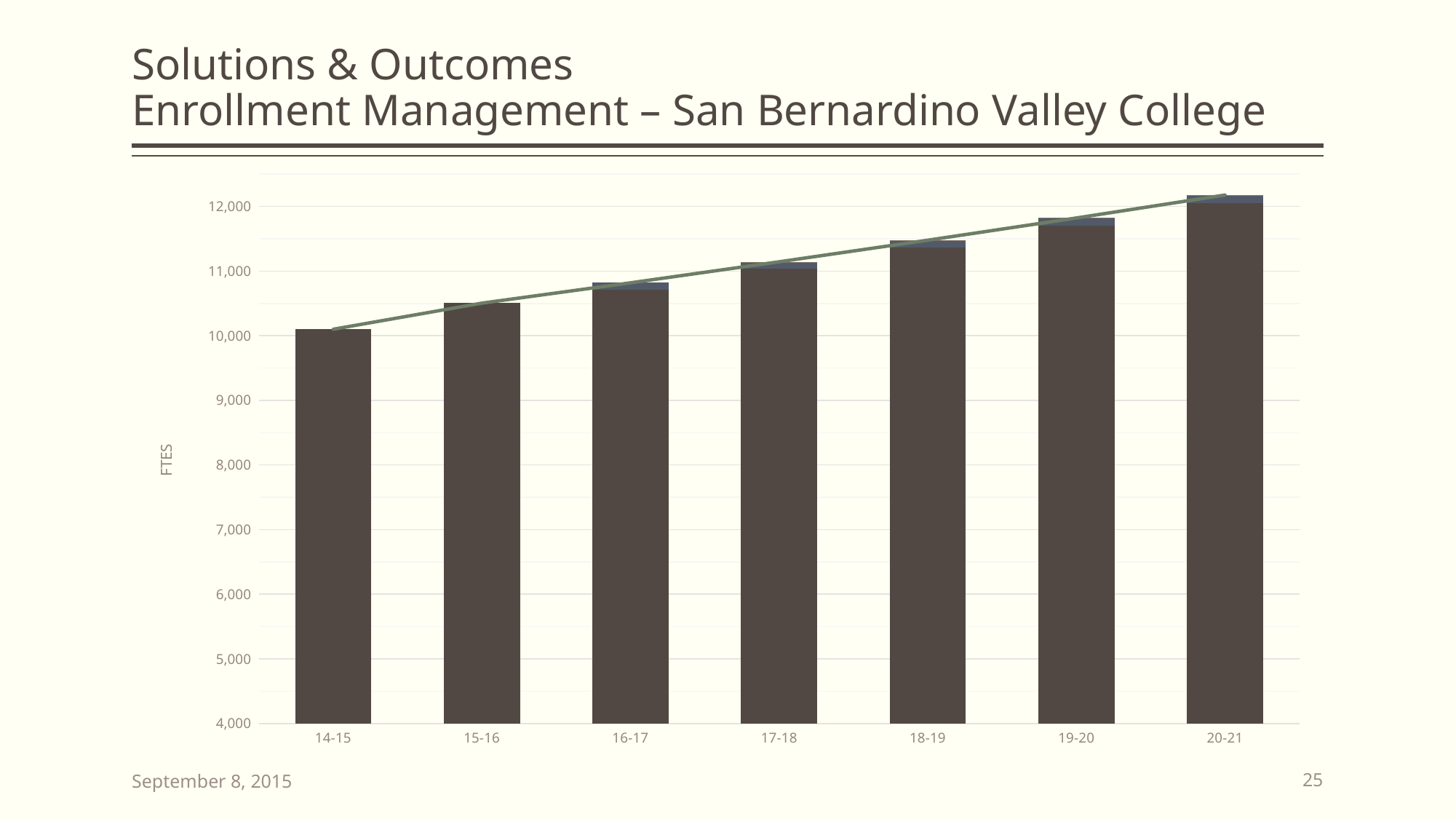
Which academic year has the highest FTES value in the chart? 20-21 How many academic years are shown on the x axis of the chart? 7 Which has the larger FTES value, 19-20 or 15-16? 19-20 Is the FTES value for 15-16 greater or less than 10,000? greater Do the FTES values rise or fall from 14-15 to 20-21? rise Is the FTES value for 14-15 greater or less than 11,000? less Is the FTES value for 16-17 greater or less than 11,000? less What is the label on the vertical axis of the chart? FTES What kind of chart is shown on the slide? combination bar and line chart Which academic year has the lowest FTES value in the chart? 14-15